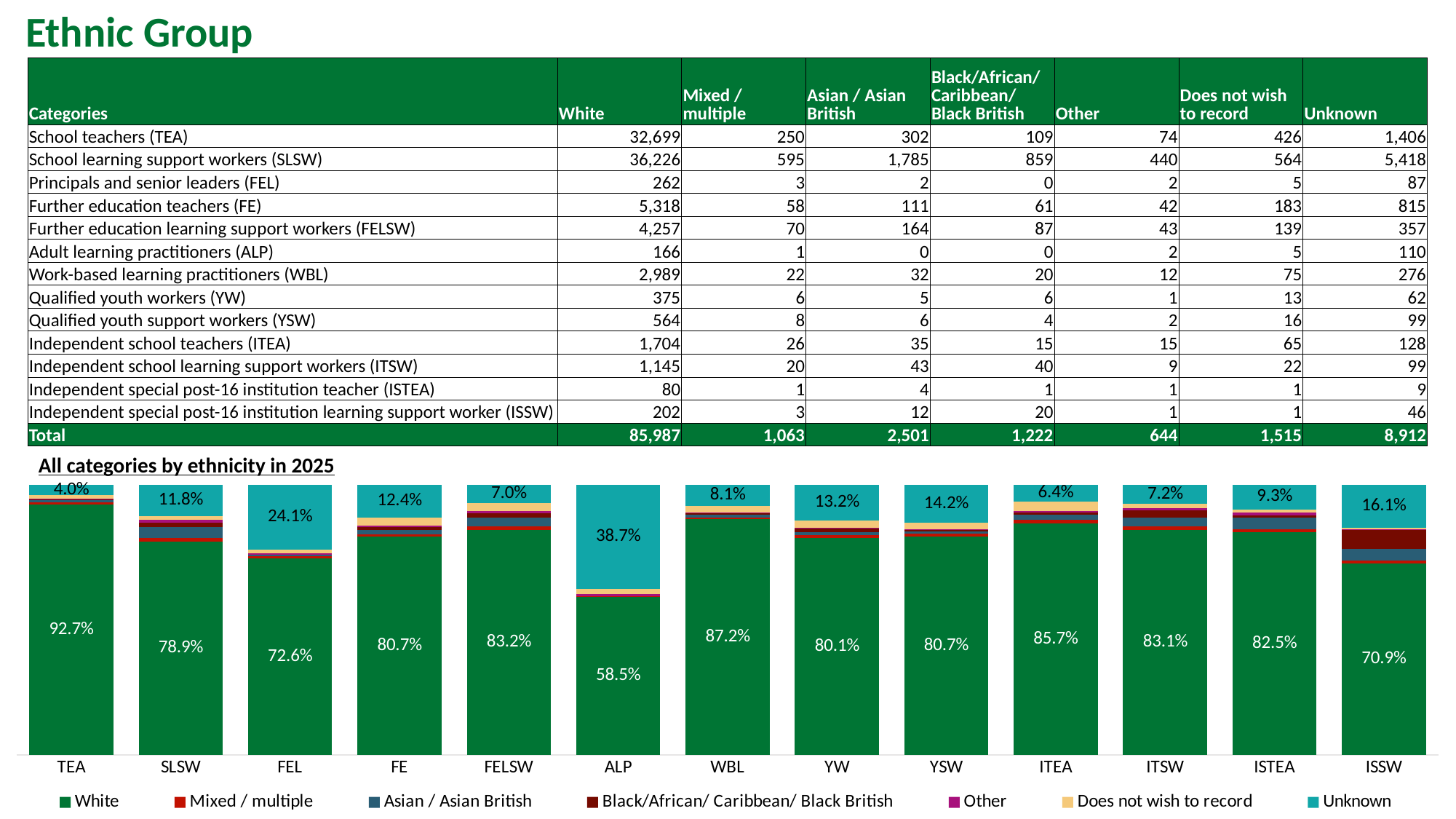
In the chart 'All categories by ethnicity in 2025', what is the White percentage for TEA? 92.7% In the chart 'All categories by ethnicity in 2025', what is the Unknown percentage for FEL? 24.1% How many categories are shown on the x axis of the chart 'All categories by ethnicity in 2025'? 13 In the chart 'All categories by ethnicity in 2025', what is the difference in percentage points between the White share for TEA and the White share for ALP? 34.2 In the chart 'All categories by ethnicity in 2025', which has the larger White percentage, SLSW or FEL? SLSW What kind of chart is 'All categories by ethnicity in 2025'? Stacked bar chart In the chart 'All categories by ethnicity in 2025', which category has the highest Unknown percentage? ALP How many series does the legend of the chart 'All categories by ethnicity in 2025' list? 7 In the chart 'All categories by ethnicity in 2025', which category has the lowest White percentage? ALP In the chart 'All categories by ethnicity in 2025', which category has the highest White percentage? TEA In the chart 'All categories by ethnicity in 2025', what is the White percentage for ISSW? 70.9% In the chart 'All categories by ethnicity in 2025', what is the Unknown percentage for ALP? 38.7%